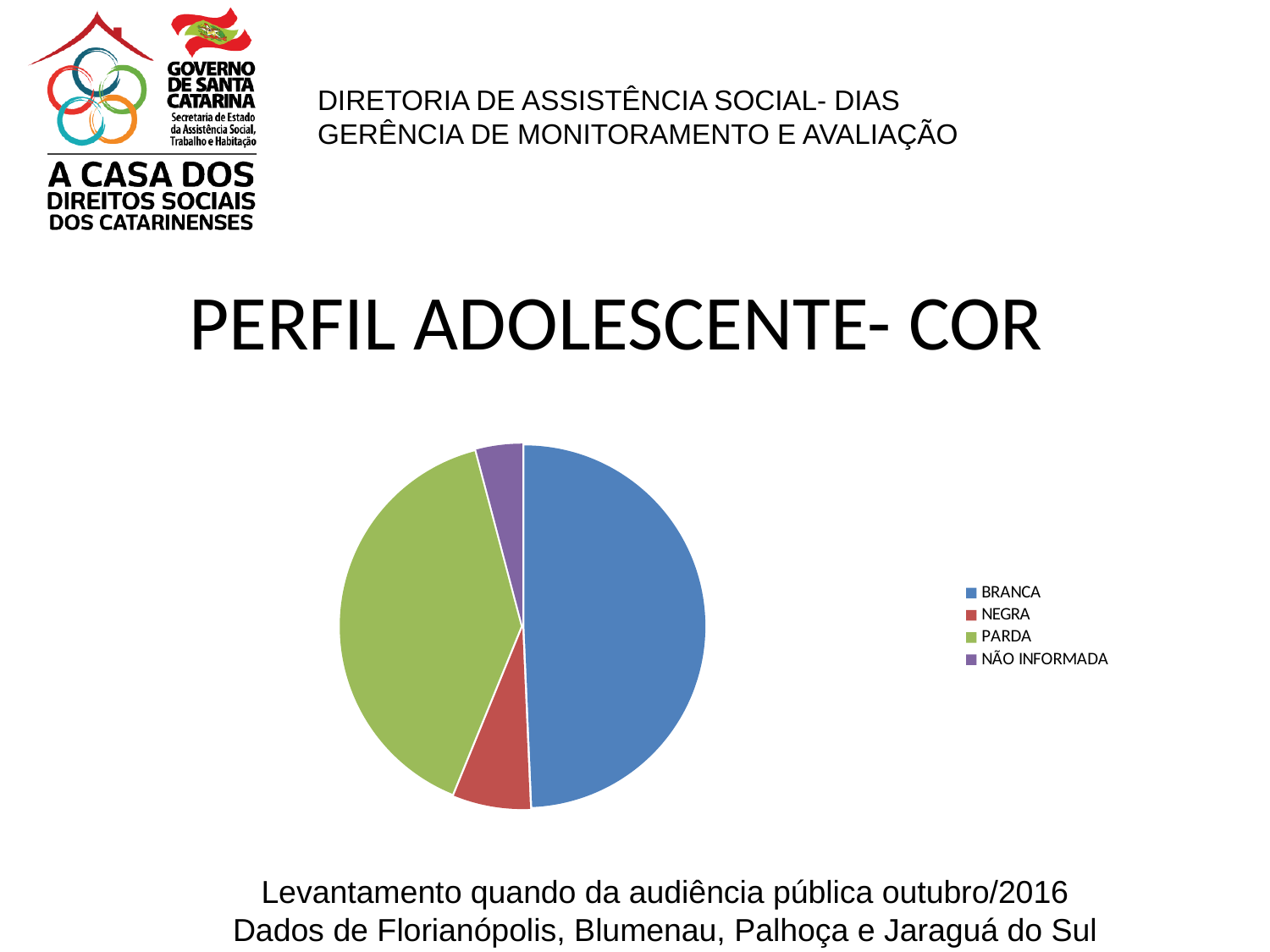
What is the title shown above the pie chart? PERFIL ADOLESCENTE- COR Which slice is larger, PARDA or NEGRA? PARDA What kind of chart is shown on the slide? pie chart Which slice is larger, BRANCA or PARDA? BRANCA Which category has the largest slice of the pie chart? BRANCA Which slice is larger, NEGRA or NÃO INFORMADA? NEGRA How many entries does the legend of the pie chart list? 4 Which colour represents the PARDA category in the pie chart? green How many categories (slices) does the pie chart have? 4 Which category has the smallest slice of the pie chart? NÃO INFORMADA